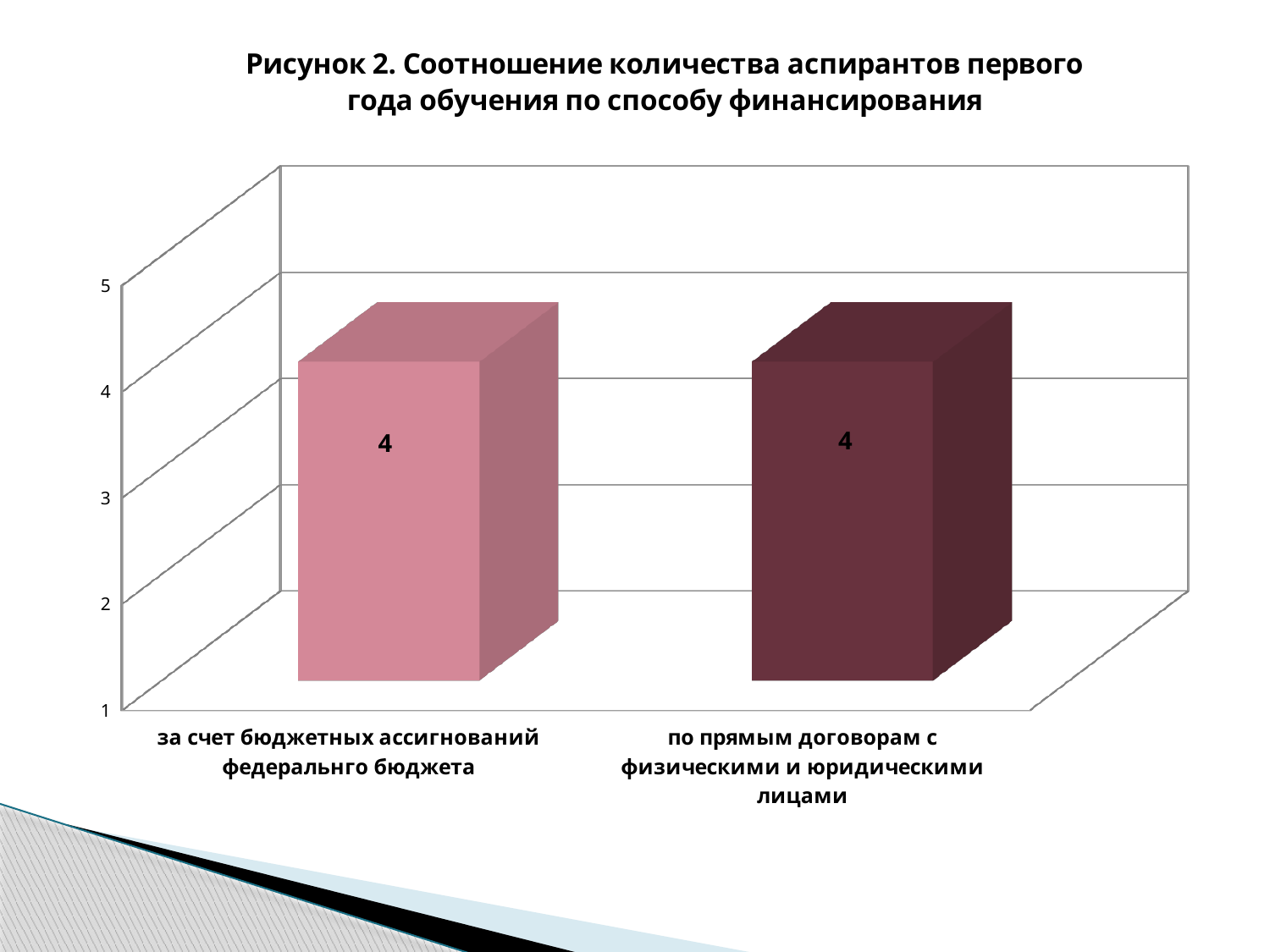
What is the title of the chart? Рисунок 2. Соотношение количества аспирантов первого года обучения по способу финансирования What kind of chart is shown on the slide? Bar chart What is the difference between the value for 'за счет бюджетных ассигнований федеральнго бюджета' and the value for 'по прямым договорам с физическими и юридическими лицами'? 0 What is the value for 'по прямым договорам с физическими и юридическими лицами'? 4 What is the value for 'за счет бюджетных ассигнований федеральнго бюджета'? 4 Is the value for 'за счет бюджетных ассигнований федеральнго бюджета' greater or less than 3? greater Which is larger: the value for 'за счет бюджетных ассигнований федеральнго бюджета' or the value for 'по прямым договорам с физическими и юридическими лицами'? They are equal How many categories are shown on the chart? 2 What colour is the bar for 'по прямым договорам с физическими и юридическими лицами'? Dark maroon Is the value for 'по прямым договорам с физическими и юридическими лицами' greater or less than 5? less